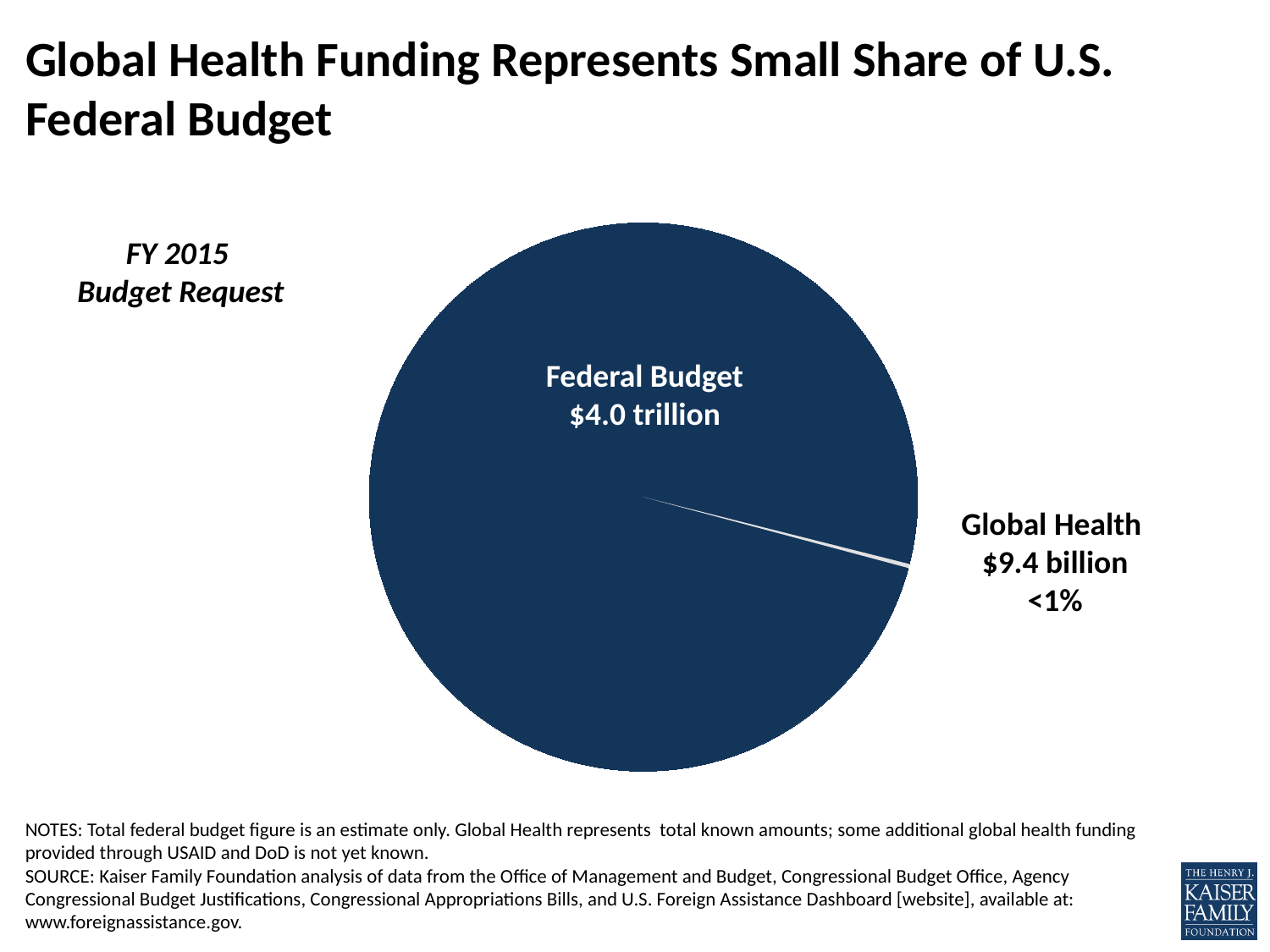
Which fiscal year budget request does the pie chart show? FY 2015 What is the title of the slide? Global Health Funding Represents Small Share of U.S. Federal Budget What share of the pie does Global Health represent, as printed on the slide? <1% Which is larger, the Federal Budget slice or the Global Health slice? Federal Budget How many slices are labeled in the pie chart? 2 Which slice of the pie is the smallest? Global Health What kind of chart is shown on the slide? pie chart Which slice of the pie is the largest? Federal Budget What is the value shown for the Global Health slice? $9.4 billion What is the value shown for the Federal Budget slice? $4.0 trillion